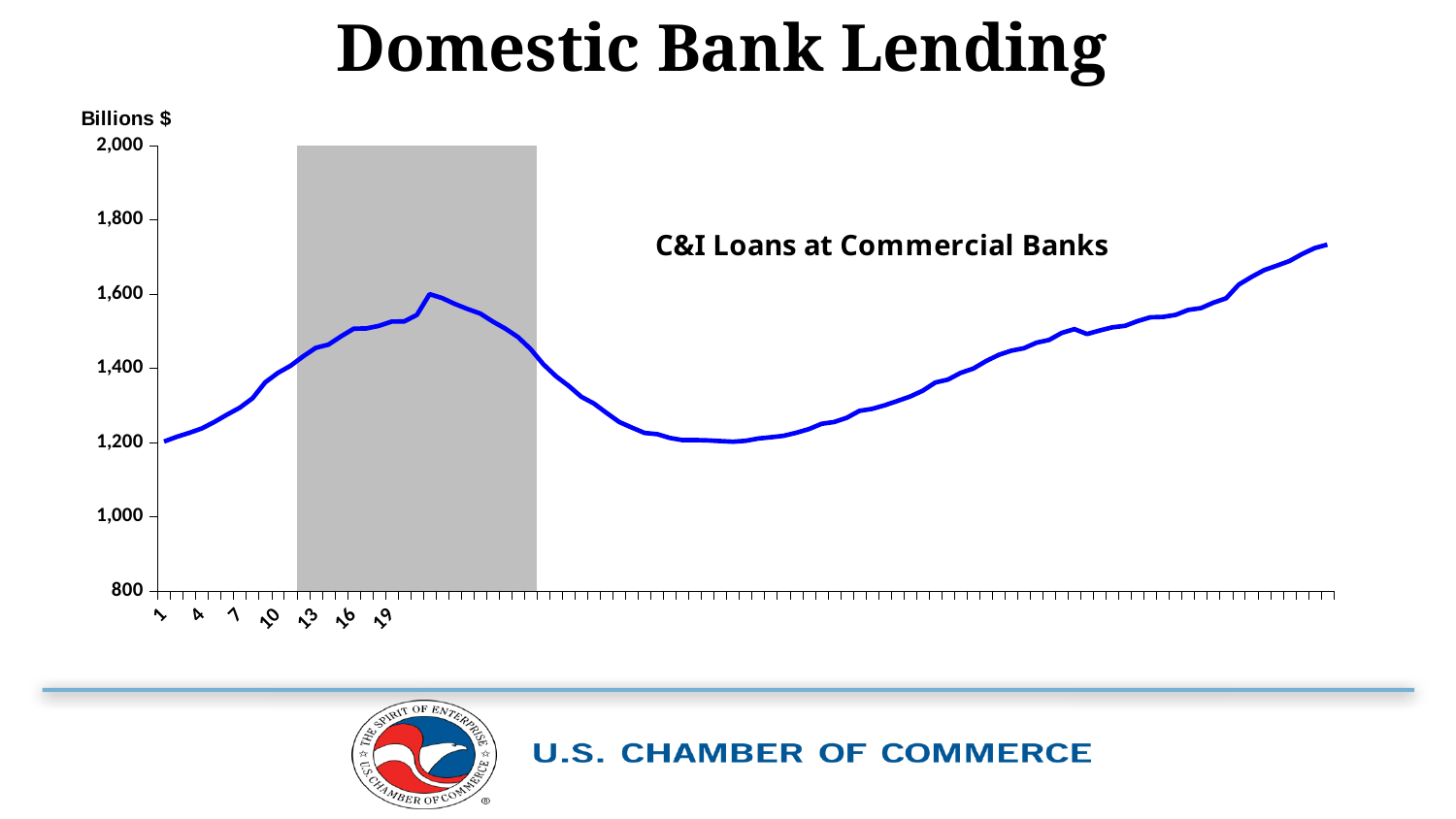
Is the value at x-axis point 13 greater or less than 1,400? greater Is the value at the last point on the right of the line greater or less than 1,800? less Is the value at x-axis point 7 greater or less than 1,200? greater Do the values rise or fall from x-axis point 1 to x-axis point 19? rise Is the value at the last point on the right of the line higher or lower than the value at x-axis point 1? higher What unit is shown on the vertical axis label? Billions $ What kind of chart is shown on the slide? line chart Which is larger, the value at x-axis point 1 or the value at x-axis point 13? point 13 What series does the chart plot? C&I Loans at Commercial Banks